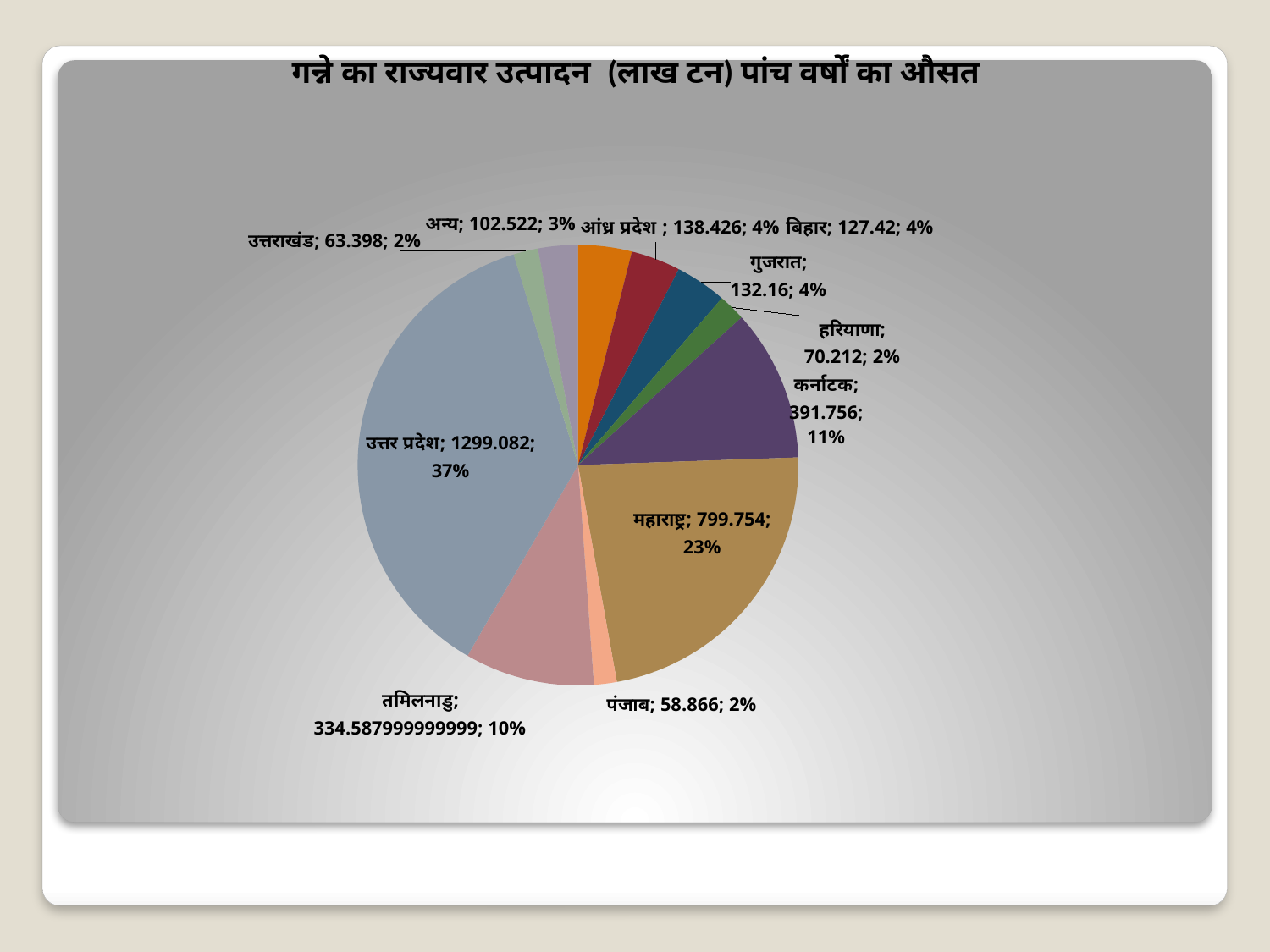
How many slices does the pie chart have? 11 What percentage share of the pie does तमिलनाडु (Tamil Nadu) have? 10% Which is larger, the value for आंध्र प्रदेश (Andhra Pradesh) or बिहार (Bihar)? आंध्र प्रदेश Which state has the largest slice of the pie? उत्तर प्रदेश What percentage share of the pie does महाराष्ट्र (Maharashtra) have? 23% Which category has the smallest value in the pie chart? पंजाब What is the value shown for पंजाब (Punjab)? 58.866 What is the value shown for कर्नाटक (Karnataka)? 391.756 What is the value shown for महाराष्ट्र (Maharashtra)? 799.754 What kind of chart is shown on the slide? pie chart What is the difference between the values for उत्तर प्रदेश and महाराष्ट्र? 499.328 What is the value shown for उत्तर प्रदेश (Uttar Pradesh)? 1299.082